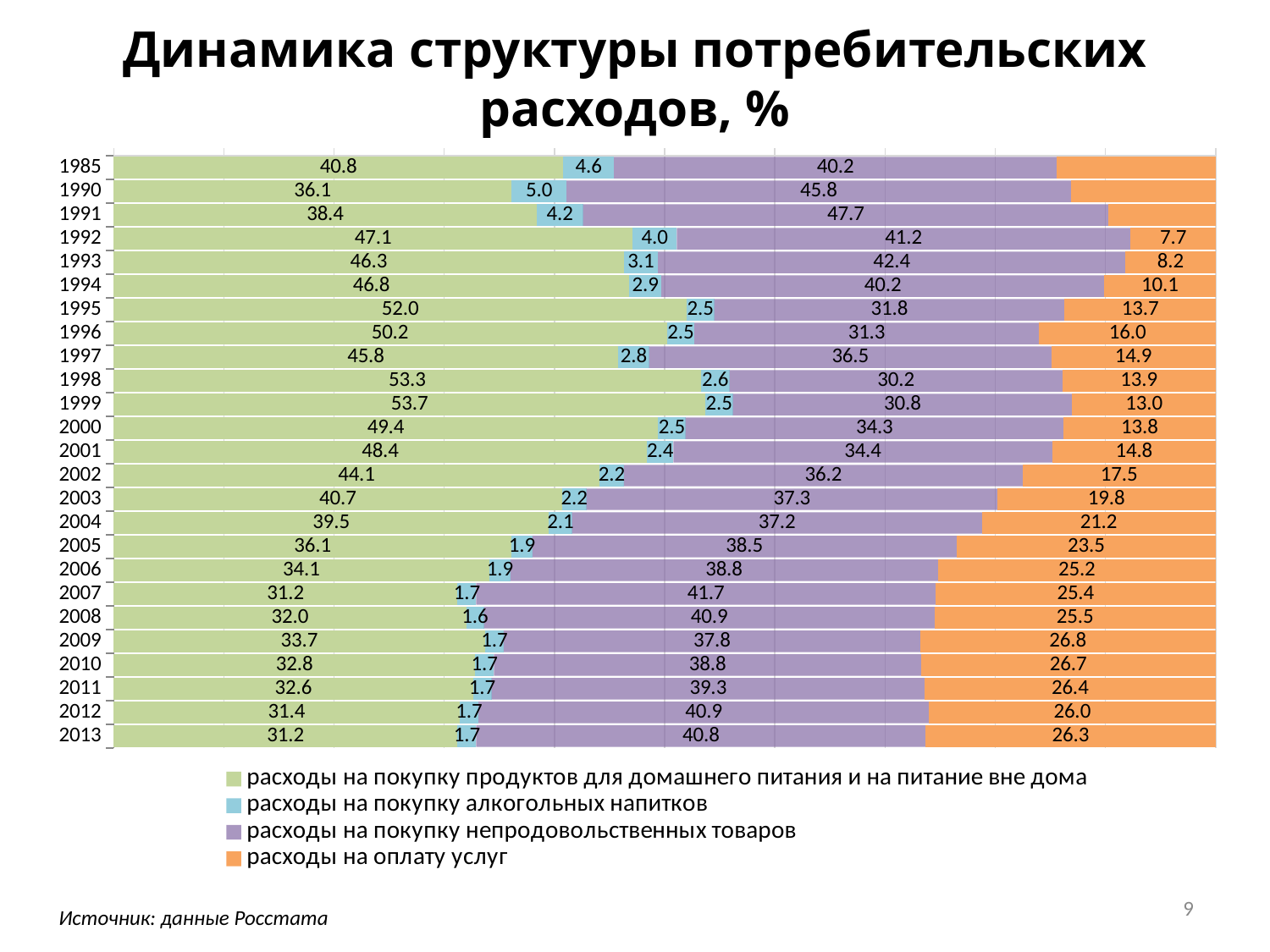
What share of consumer spending went to food (расходы на покупку продуктов для домашнего питания и на питание вне дома) in 1999? 53.7 What is the total of the stacked bar for 2013? 100.0 How many years are shown on the chart? 25 By how much does the value for расходы на оплату услуг in 2013 exceed the value in 1992? 18.6 Which year has the larger share of расходы на покупку продуктов для домашнего питания и на питание вне дома, 1995 or 2005? 1995 What is the value for расходы на оплату услуг in 2013? 26.3 In which year is the share of расходы на покупку продуктов для домашнего питания и на питание вне дома the highest? 1999 What is the value for расходы на покупку алкогольных напитков in 1990? 5.0 What kind of chart is shown on the slide? Stacked bar chart Does the share of расходы на покупку алкогольных напитков rise or fall from 1985 to 2013? Falls How many series does the legend list? 4 In which year is the share of расходы на покупку непродовольственных товаров the highest? 1991